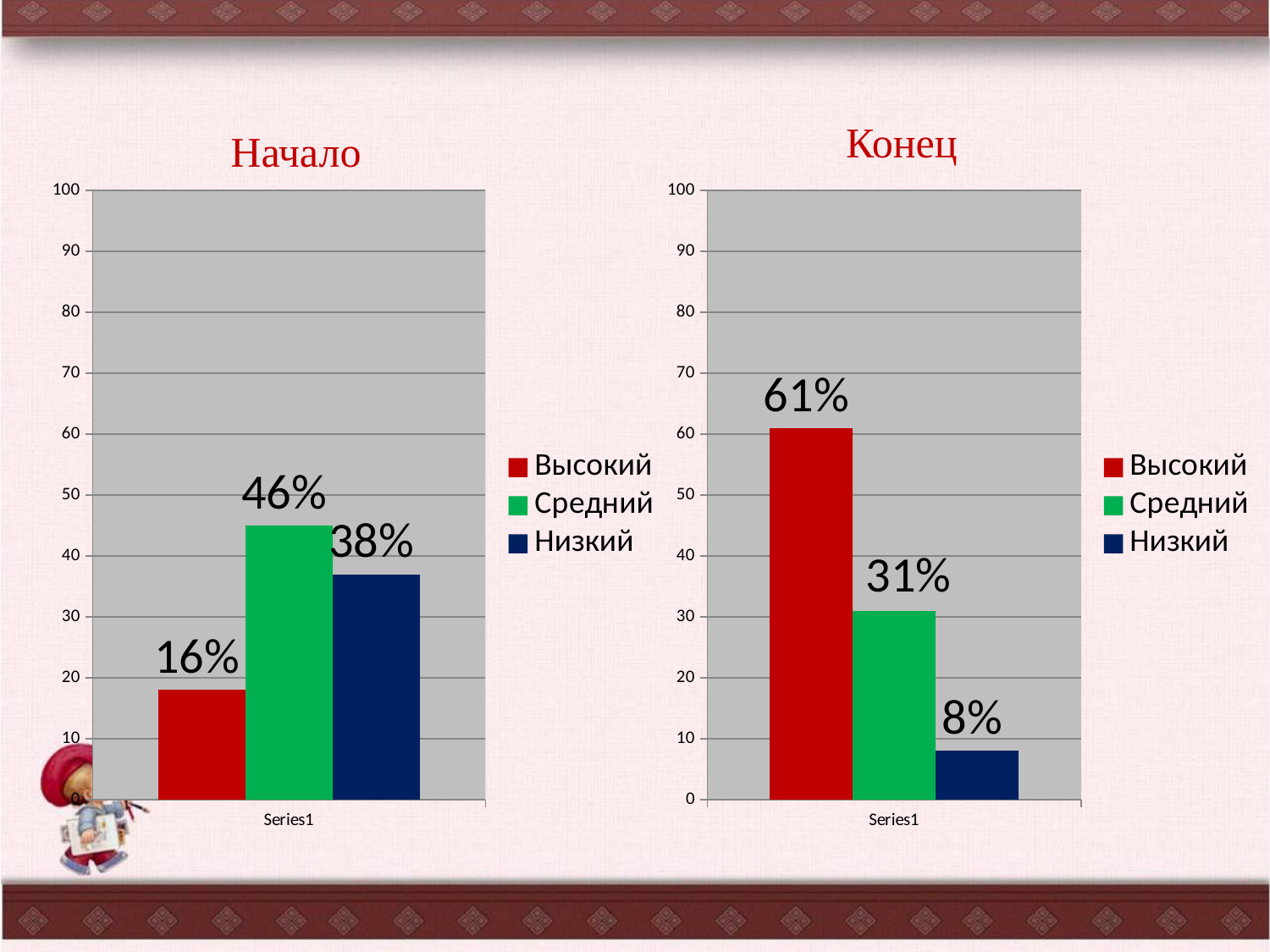
In the "Конец" chart, what is the value for Низкий? 8% In the "Конец" chart, what colour is the bar for Средний? green In the "Начало" chart, what is the value for Средний? 46% In the "Начало" chart, what is the difference between Средний and Низкий? 8% In the "Начало" chart, which is larger, Высокий or Низкий? Низкий In the "Начало" chart, which category has the highest value? Средний How many series does the legend of the "Конец" chart list? 3 In the "Конец" chart, what is the difference between Высокий and Средний? 30% In the "Конец" chart, which category has the lowest value? Низкий What kind of chart is the "Начало" chart? bar chart In the "Начало" chart, what is the value for Высокий? 16% In the "Конец" chart, what is the value for Высокий? 61%